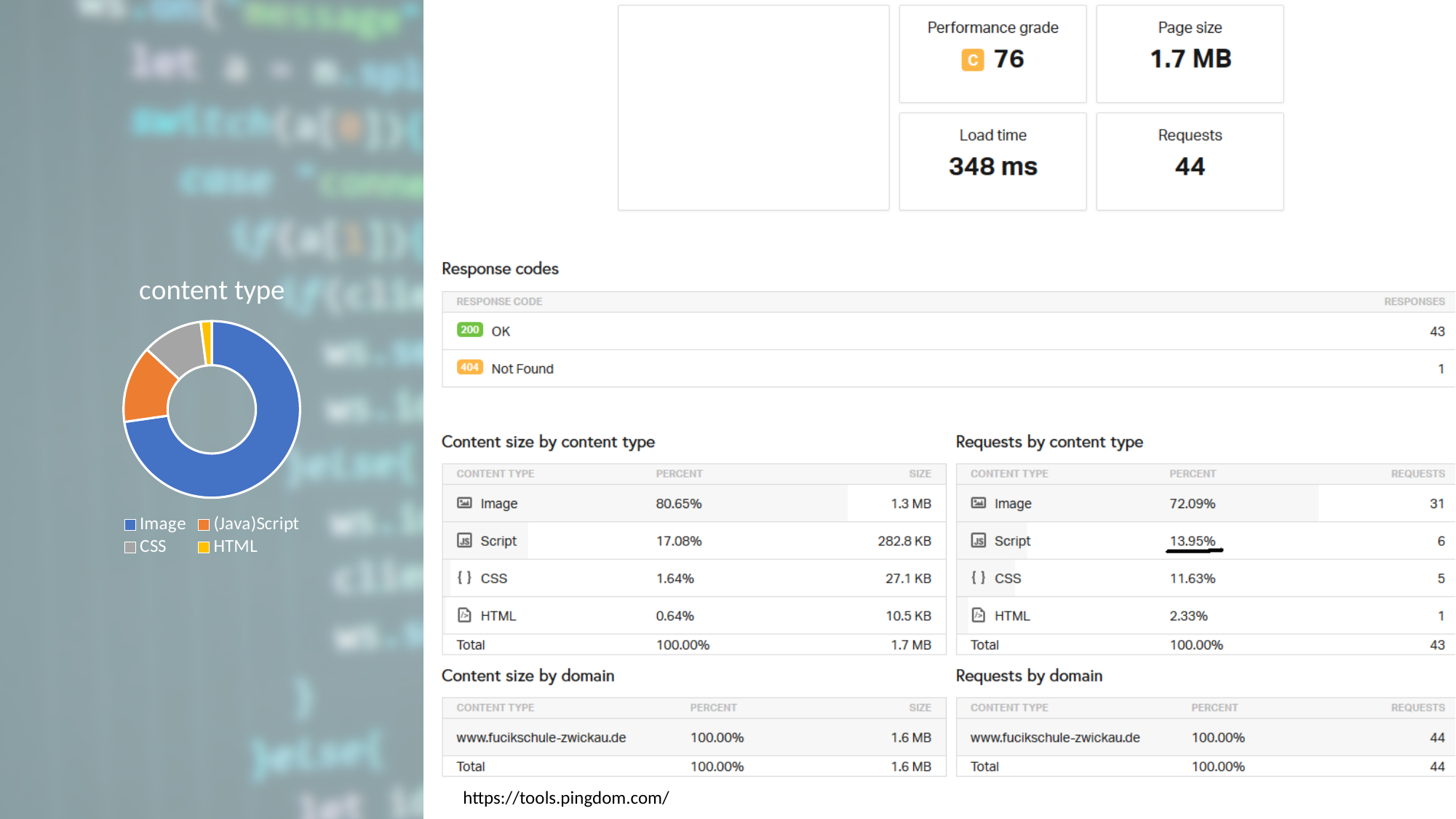
What is the title of the chart on the left of the slide? content type In the content type chart, which slice is larger: (Java)Script or HTML? (Java)Script In the content type chart, which slice is larger: Image or (Java)Script? Image How many categories does the legend of the content type chart list? 4 In the content type chart, which slice is larger: CSS or HTML? CSS What colour represents Image in the content type chart? blue What kind of chart is shown on the left of the slide? doughnut chart Which content type has the largest slice in the content type chart? Image Which content type has the smallest slice in the content type chart? HTML